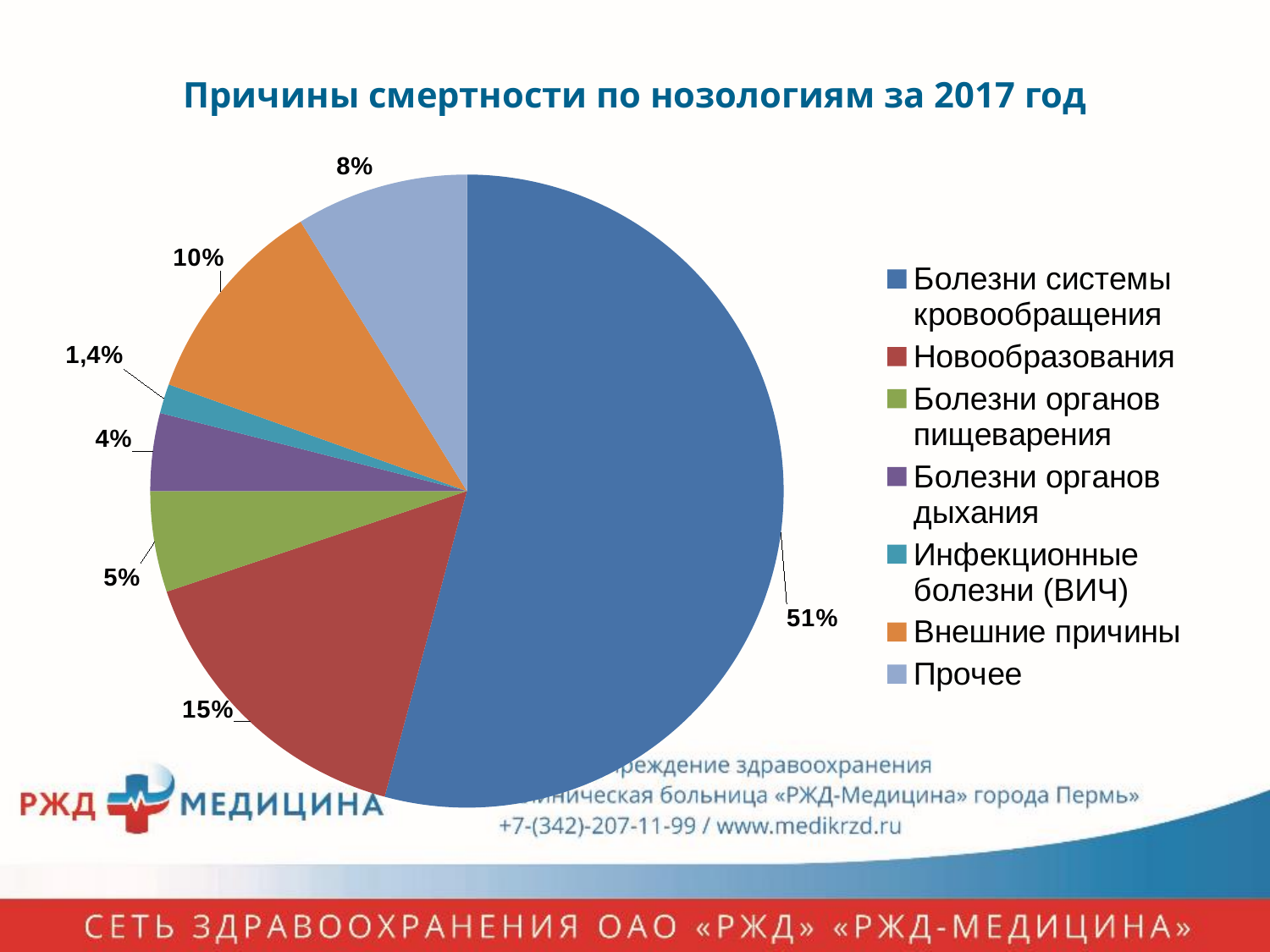
What share of the pie is labelled for Внешние причины? 10% How many categories does the legend list? 7 What share of the pie is labelled for Прочее? 8% What share of the pie is labelled for Инфекционные болезни (ВИЧ)? 1,4% What is the difference between the shares for Новообразования and Внешние причины? 5% Which category has the largest slice of the pie? Болезни системы кровообращения What is the title of the chart? Причины смертности по нозологиям за 2017 год What kind of chart is shown on the slide? Pie chart Which category has the smallest slice of the pie? Инфекционные болезни (ВИЧ) Which is larger, the share for Болезни органов пищеварения or the share for Болезни органов дыхания? Болезни органов пищеварения